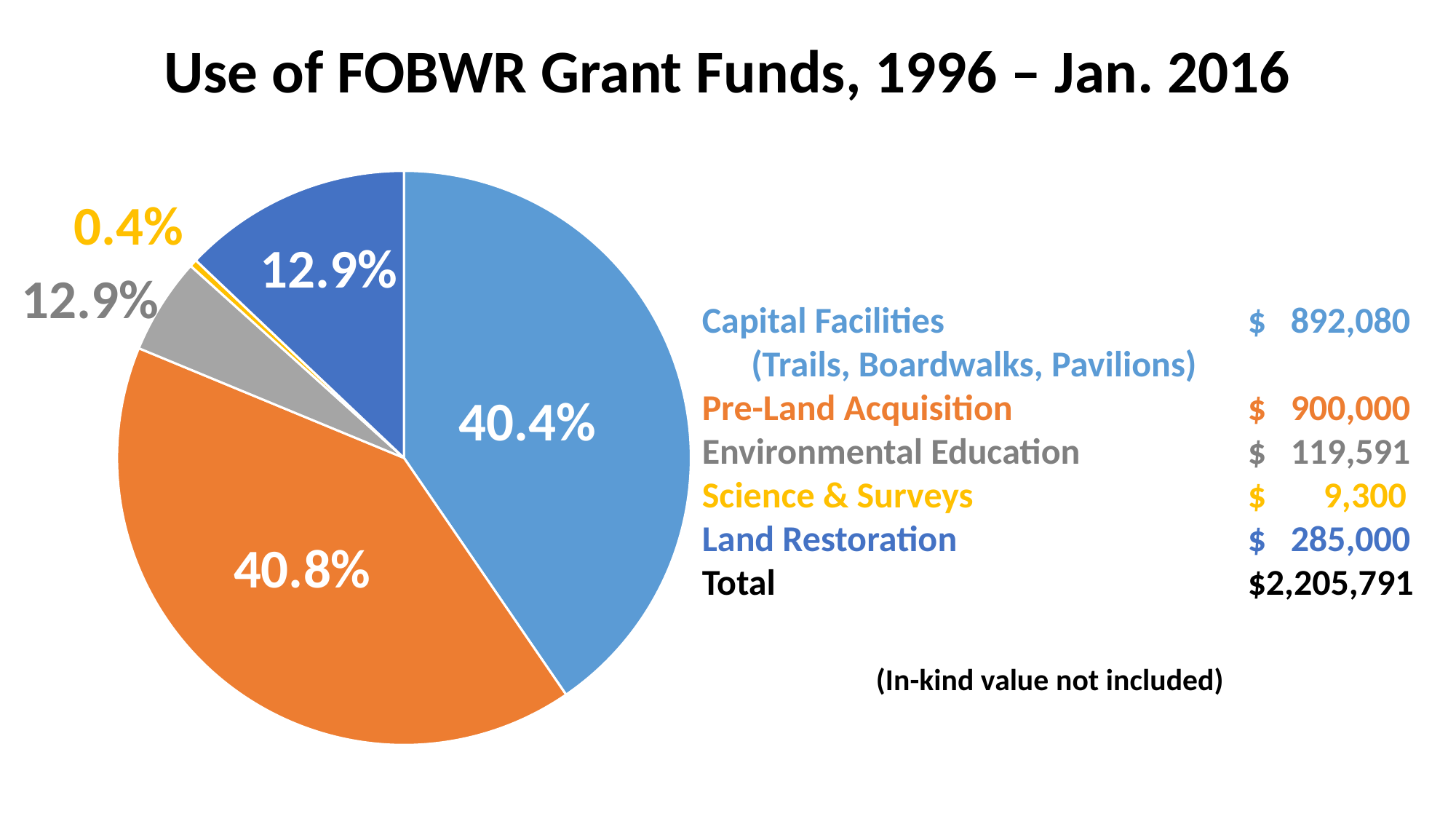
What type of chart is shown on the slide? Pie chart What is the difference in dollars between Pre-Land Acquisition and Capital Facilities? $7,920 What share of the pie does Capital Facilities (Trails, Boardwalks, Pavilions) represent? 40.4% What share of the pie does Pre-Land Acquisition represent? 40.8% What dollar amount is listed for Environmental Education? $ 119,591 What is the total of all grant funds shown? $2,205,791 Which category has the largest share of the pie? Pre-Land Acquisition What share of the pie does Science & Surveys represent? 0.4% Which category has the smallest share of the pie? Science & Surveys How many categories are shown in the pie chart? 5 What is the title of the chart? Use of FOBWR Grant Funds, 1996 – Jan. 2016 What dollar amount is listed for Land Restoration? $ 285,000